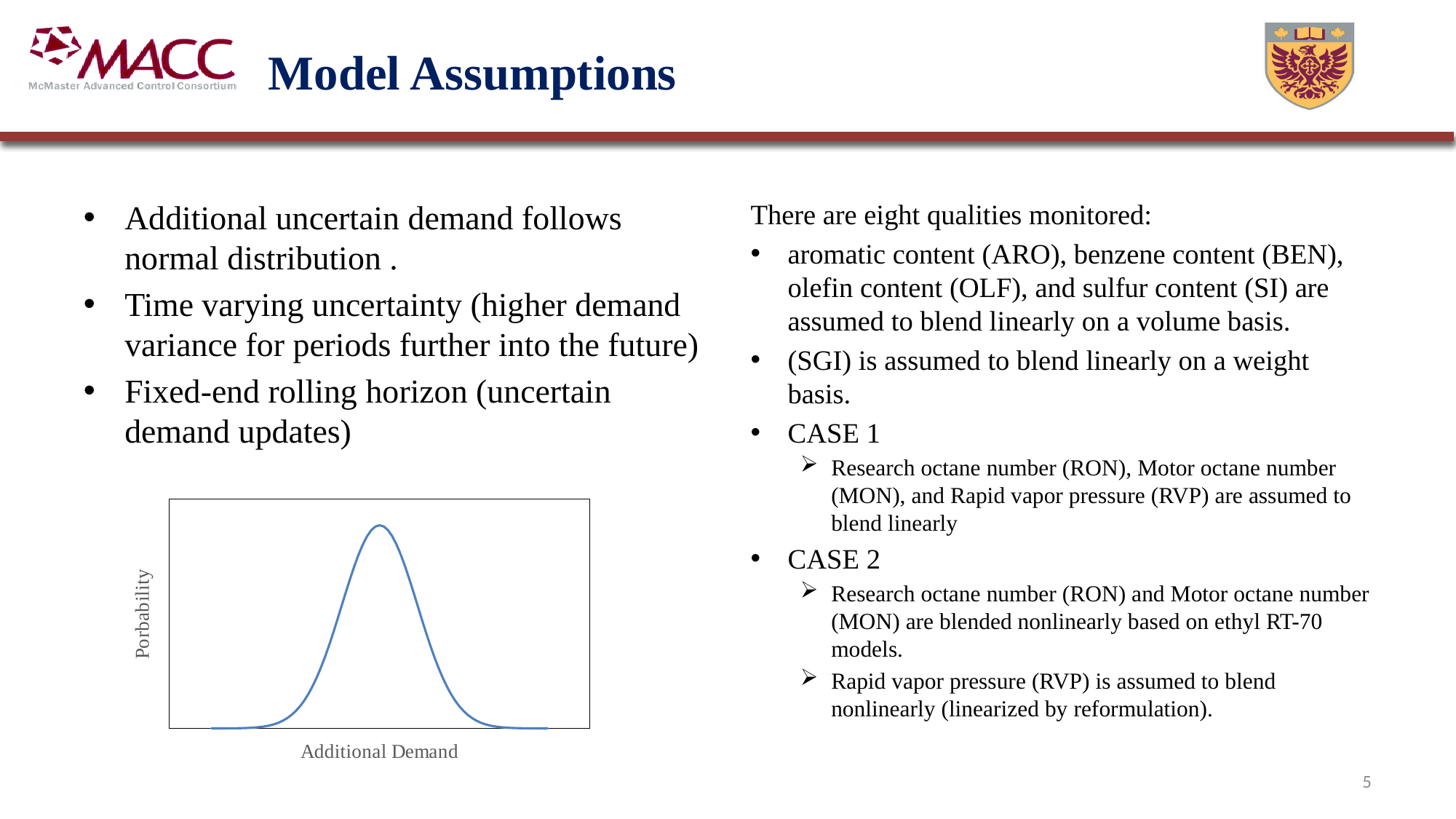
Does the curve rise or fall as it moves from the left edge of the chart toward the centre? rise What is the label on the x axis of the chart? Additional Demand Does the curve rise or fall as it moves from the centre of the chart toward the right edge? fall How many lines are plotted in the chart? 1 What is the label on the y axis of the chart? Porbability What kind of chart is shown on the slide? line chart